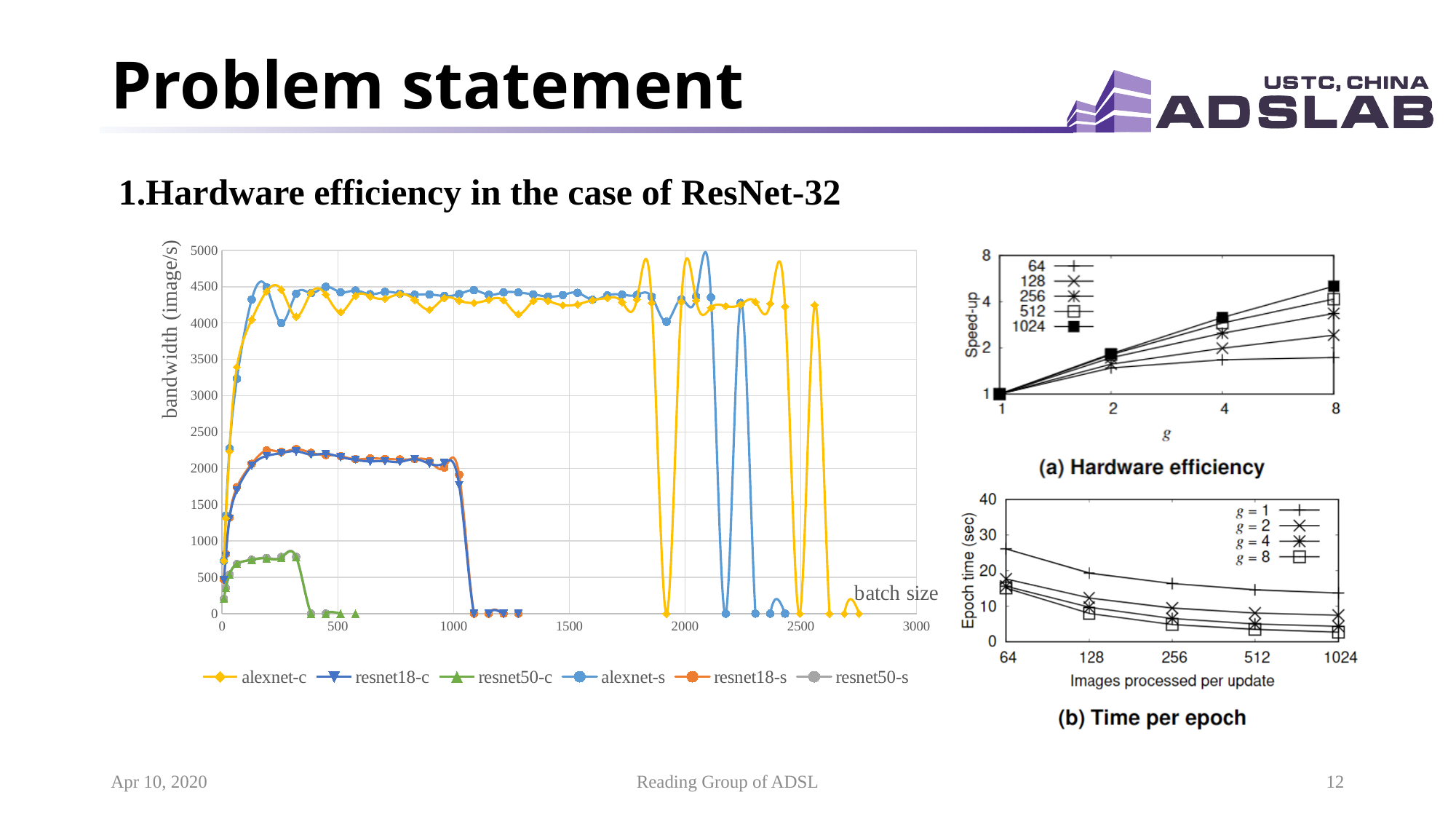
In the large left chart, at batch size 500, which series has the higher bandwidth, alexnet-c or resnet50-c? alexnet-c What is the y-axis label of the large left chart? bandwidth (image/s) In chart (b) Time per epoch, is the epoch time for g = 1 at 64 images processed per update greater or less than 20? greater In the large left chart, is the bandwidth for alexnet-c at batch size 1000 greater or less than 4000? greater How many series does the legend of the large left chart list? 6 In chart (a) Hardware efficiency, how many series does the legend list? 5 What kind of chart is the large chart on the left showing bandwidth against batch size? line chart In chart (a) Hardware efficiency, which series has the highest speed-up at g = 8? 1024 In chart (b) Time per epoch, how many series does the legend list? 4 In chart (a) Hardware efficiency, is the speed-up for the 64 series at g = 8 greater or less than 2? less In chart (b) Time per epoch, does the epoch time for g = 1 rise or fall as images processed per update increases? fall